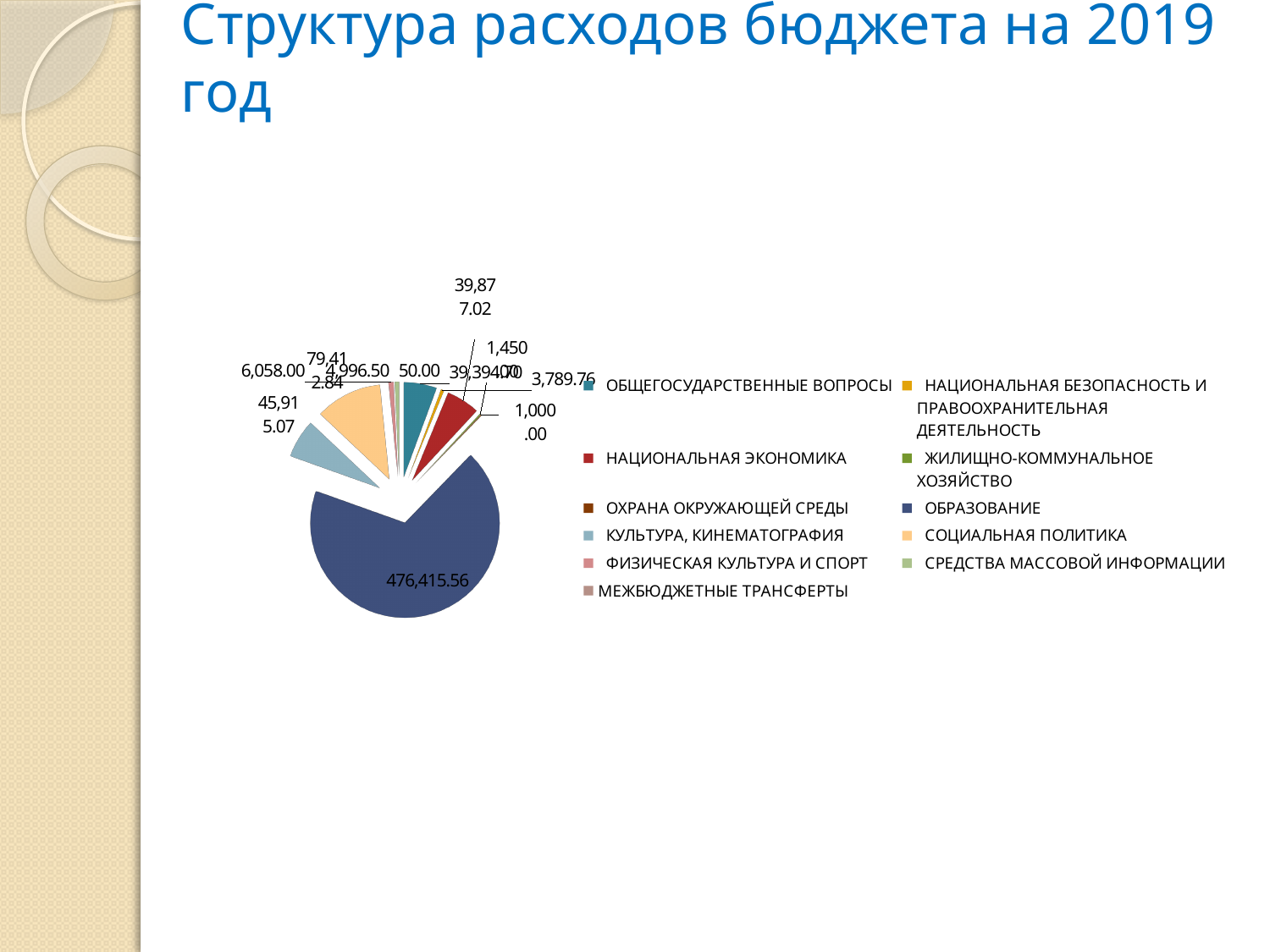
What is the value shown for ОБРАЗОВАНИЕ in the pie chart? 476,415.56 What is the value shown for ОБЩЕГОСУДАРСТВЕННЫЕ ВОПРОСЫ in the pie chart? 39,394.70 Which category has the largest slice in the pie chart? ОБРАЗОВАНИЕ What is the value shown for КУЛЬТУРА, КИНЕМАТОГРАФИЯ in the pie chart? 45,915.07 What is the value shown for СОЦИАЛЬНАЯ ПОЛИТИКА in the pie chart? 79,412.84 What is the value shown for НАЦИОНАЛЬНАЯ ЭКОНОМИКА in the pie chart? 39,877.02 How many categories does the legend of the pie chart list? 11 What type of chart is shown on the slide? pie chart Which is larger in the pie chart: СОЦИАЛЬНАЯ ПОЛИТИКА or КУЛЬТУРА, КИНЕМАТОГРАФИЯ? СОЦИАЛЬНАЯ ПОЛИТИКА Which is larger in the pie chart: ОБРАЗОВАНИЕ or СОЦИАЛЬНАЯ ПОЛИТИКА? ОБРАЗОВАНИЕ What is the difference between the values for ОБРАЗОВАНИЕ and СОЦИАЛЬНАЯ ПОЛИТИКА in the pie chart? 397,002.72 What is the title of the slide containing the chart? Структура расходов бюджета на 2019 год